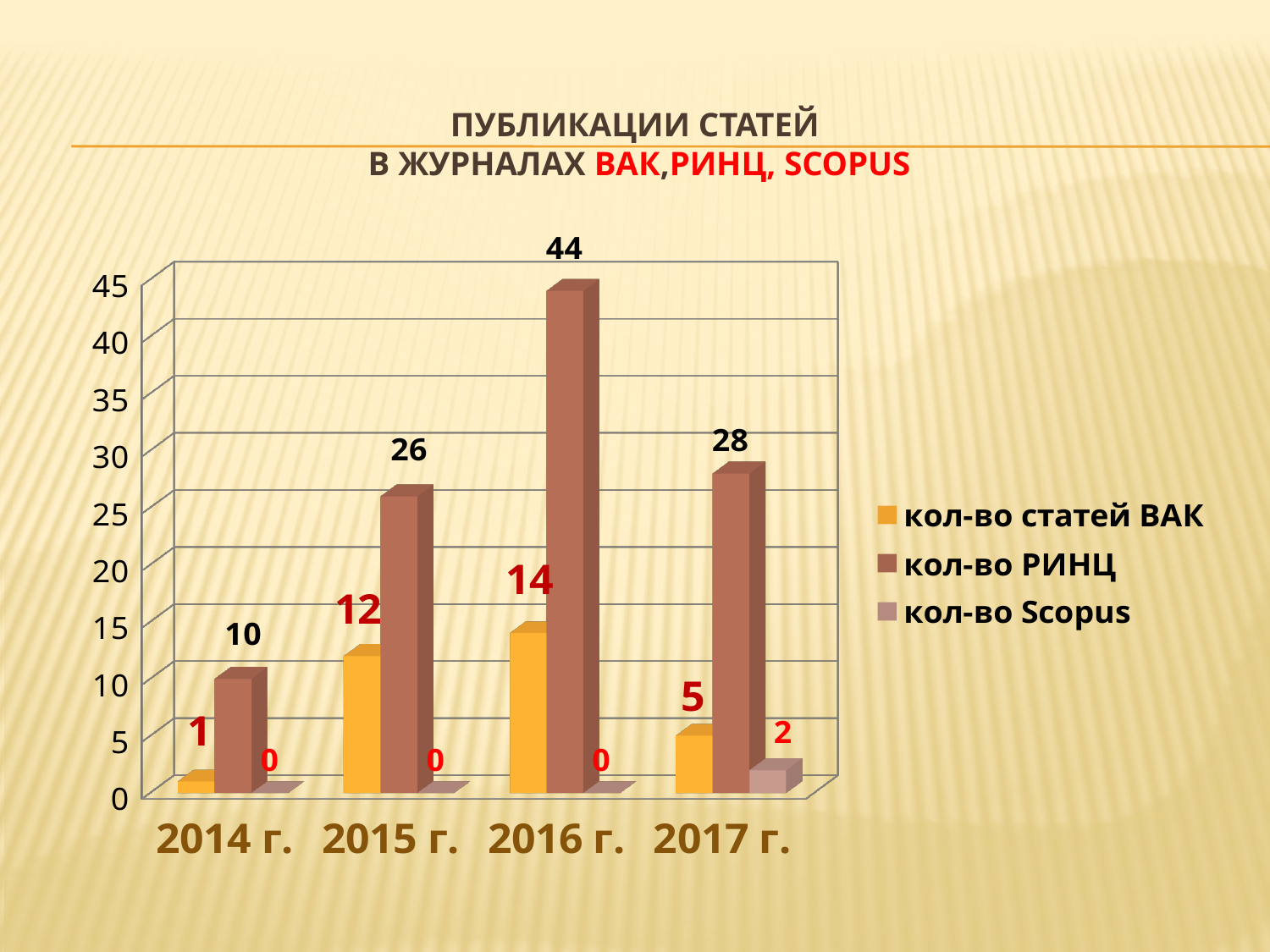
What is the value for кол-во РИНЦ in 2016 г.? 44 How many years are shown on the x axis? 4 Does the value for кол-во статей ВАК rise or fall from 2014 г. to 2016 г.? rise What is the value for кол-во Scopus in 2017 г.? 2 What is the difference between кол-во РИНЦ in 2016 г. and in 2017 г.? 16 What kind of chart is shown on the slide? bar chart In which year is the value for кол-во статей ВАК lowest? 2014 г. In which year is the value for кол-во РИНЦ highest? 2016 г. What is the value for кол-во статей ВАК in 2015 г.? 12 How many series does the legend list? 3 Which is larger: кол-во статей ВАК in 2016 г. or кол-во статей ВАК in 2017 г.? 2016 г. What is the total of all three series in 2017 г.? 35